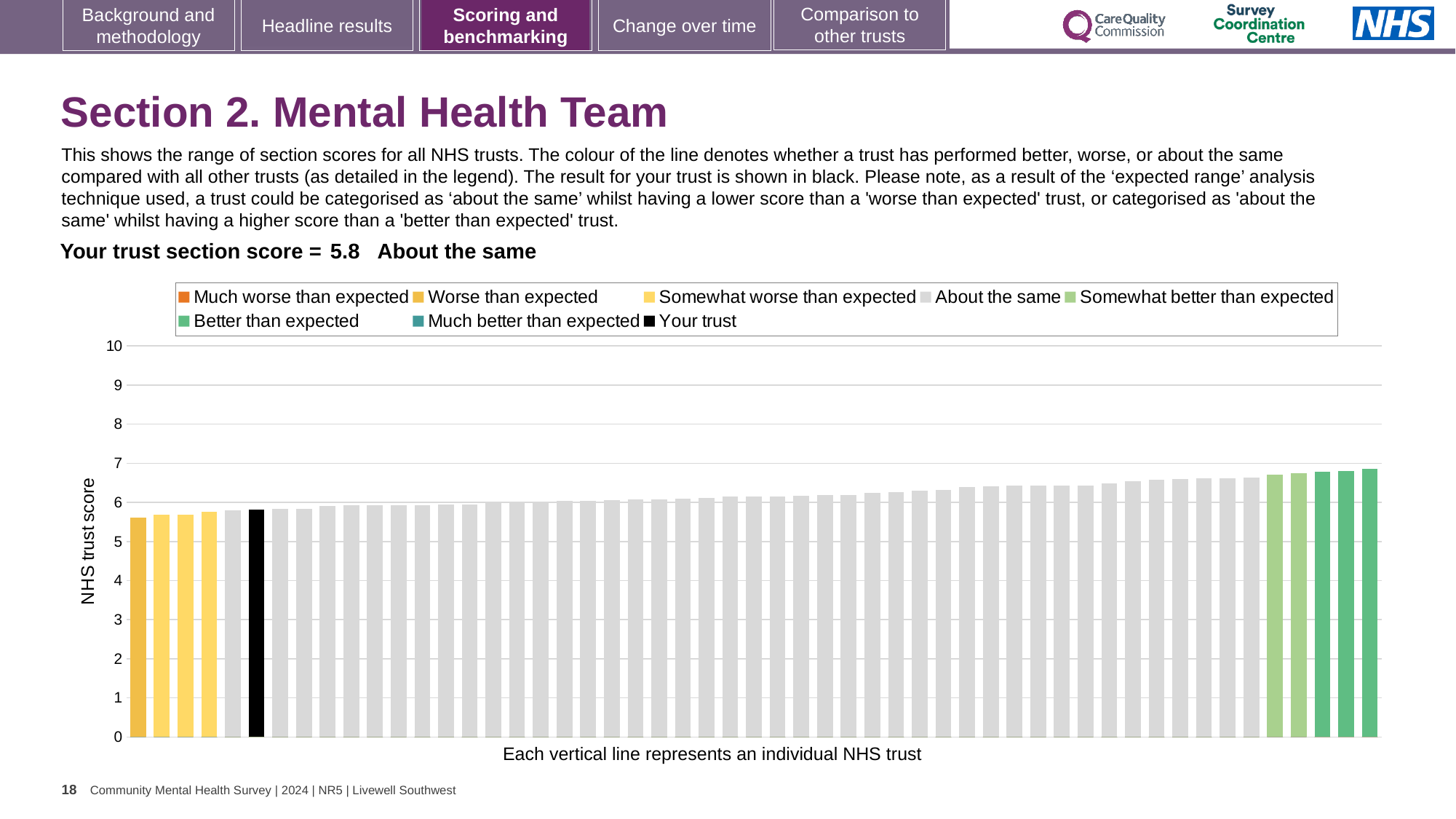
Which category is your trust placed in for this section? About the same What is the section score for your trust shown on the slide? 5.8 What colour is the bar representing your trust? black Is the value of the shortest bar in the chart greater or less than 5? greater How many entries does the chart legend list? 8 What is the label on the vertical axis of the chart? NHS trust score Is the value of the black bar (your trust) greater or less than 5? greater What kind of chart is shown on the slide? bar chart Is the value of the tallest bar greater or less than 6? greater Which legend category do the tallest bars on the right of the chart belong to? Better than expected Do the bar values rise or fall from left to right along the x axis? rise